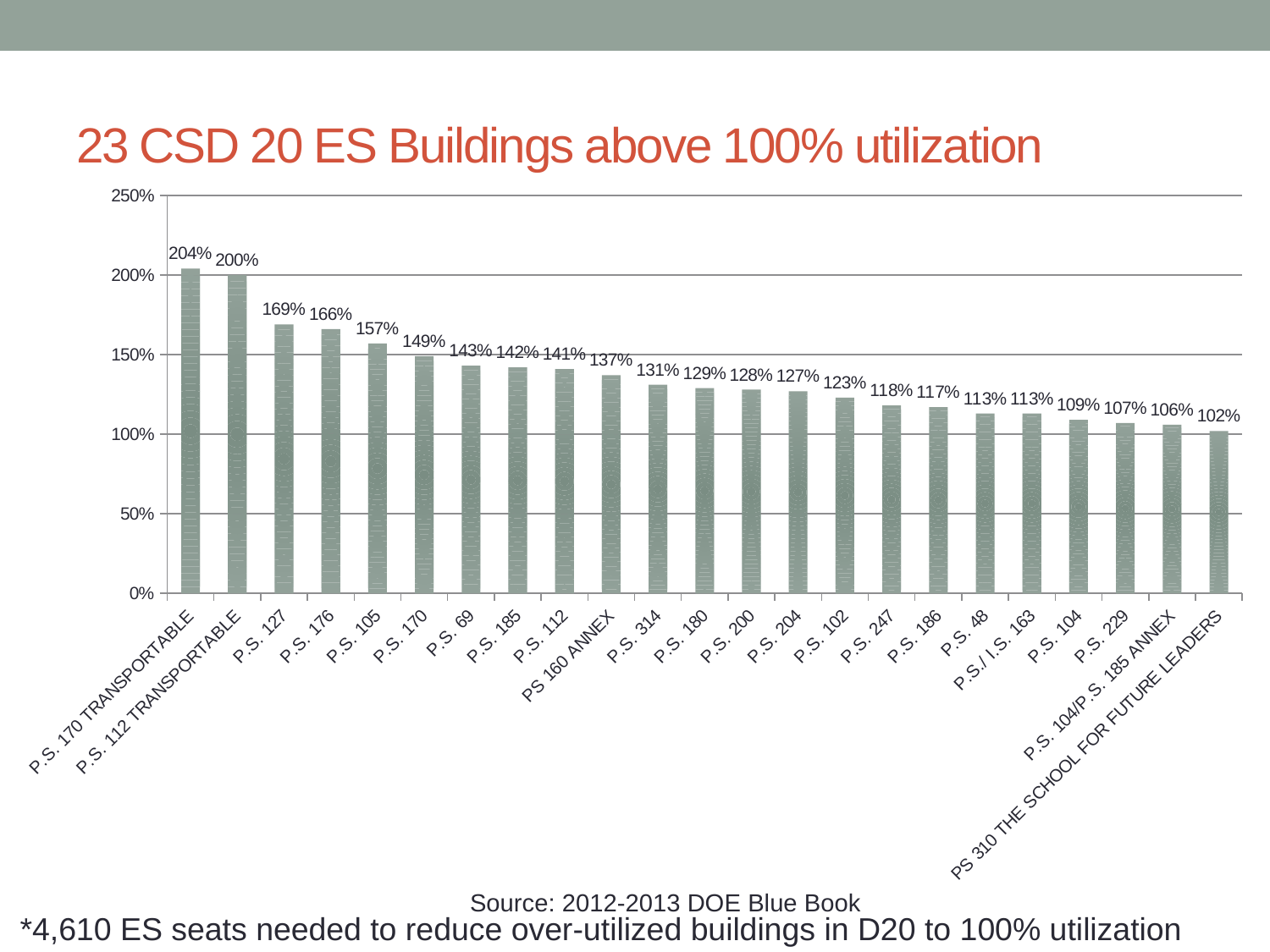
What is the utilization value for P.S. 314? 131% Which building has the highest utilization? P.S. 170 TRANSPORTABLE Which building has the lowest utilization? PS 310 THE SCHOOL FOR FUTURE LEADERS Which has a higher utilization, P.S. 176 or P.S. 180? P.S. 176 What is the difference in utilization between P.S. 170 TRANSPORTABLE and P.S. 112 TRANSPORTABLE? 4% What is the difference in utilization between P.S. 105 and P.S. 102? 34% How many buildings are shown in the chart? 23 What kind of chart is shown on the slide? bar chart What is the utilization value for P.S. 229? 107% Is the utilization for P.S. 69 greater or less than 150%? less Do the utilization values rise or fall from left to right along the x axis? fall What is the utilization value for P.S. 127? 169%